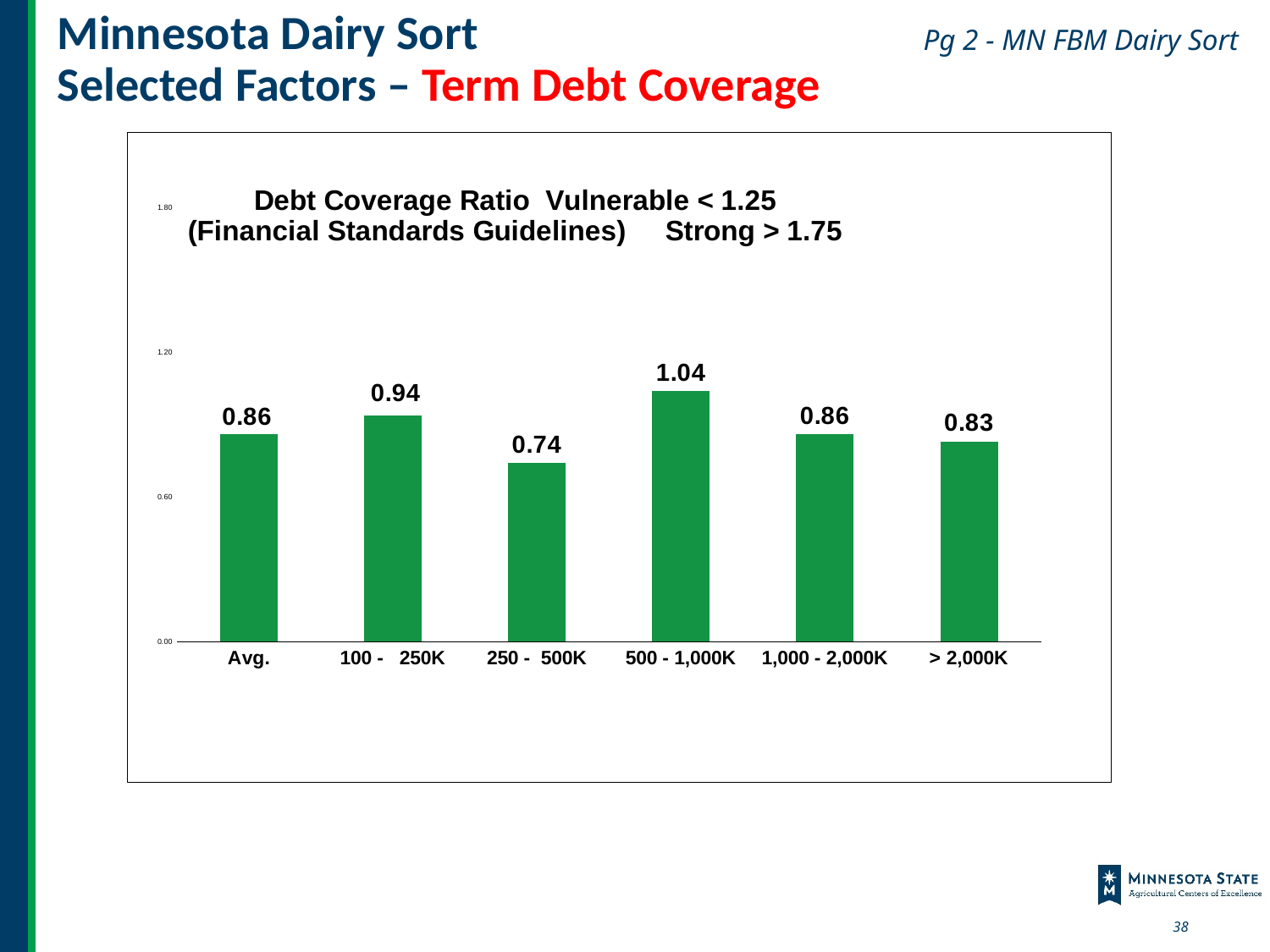
Is the debt coverage ratio for 500 - 1,000K greater or less than 1.20? less Which category has the highest debt coverage ratio? 500 - 1,000K According to the chart title, what debt coverage ratio is considered strong? > 1.75 What is the debt coverage ratio for the > 2,000K group? 0.83 What is the difference between the debt coverage ratio for 100 - 250K and 1,000 - 2,000K? 0.08 What is the debt coverage ratio for the 500 - 1,000K group? 1.04 What is the difference between the debt coverage ratio for 500 - 1,000K and 250 - 500K? 0.30 How many categories are shown on the x axis of the chart? 6 What is the debt coverage ratio for the Avg. category? 0.86 What kind of chart is shown on the slide? bar chart Which has a larger debt coverage ratio, 100 - 250K or > 2,000K? 100 - 250K Which category has the lowest debt coverage ratio? 250 - 500K